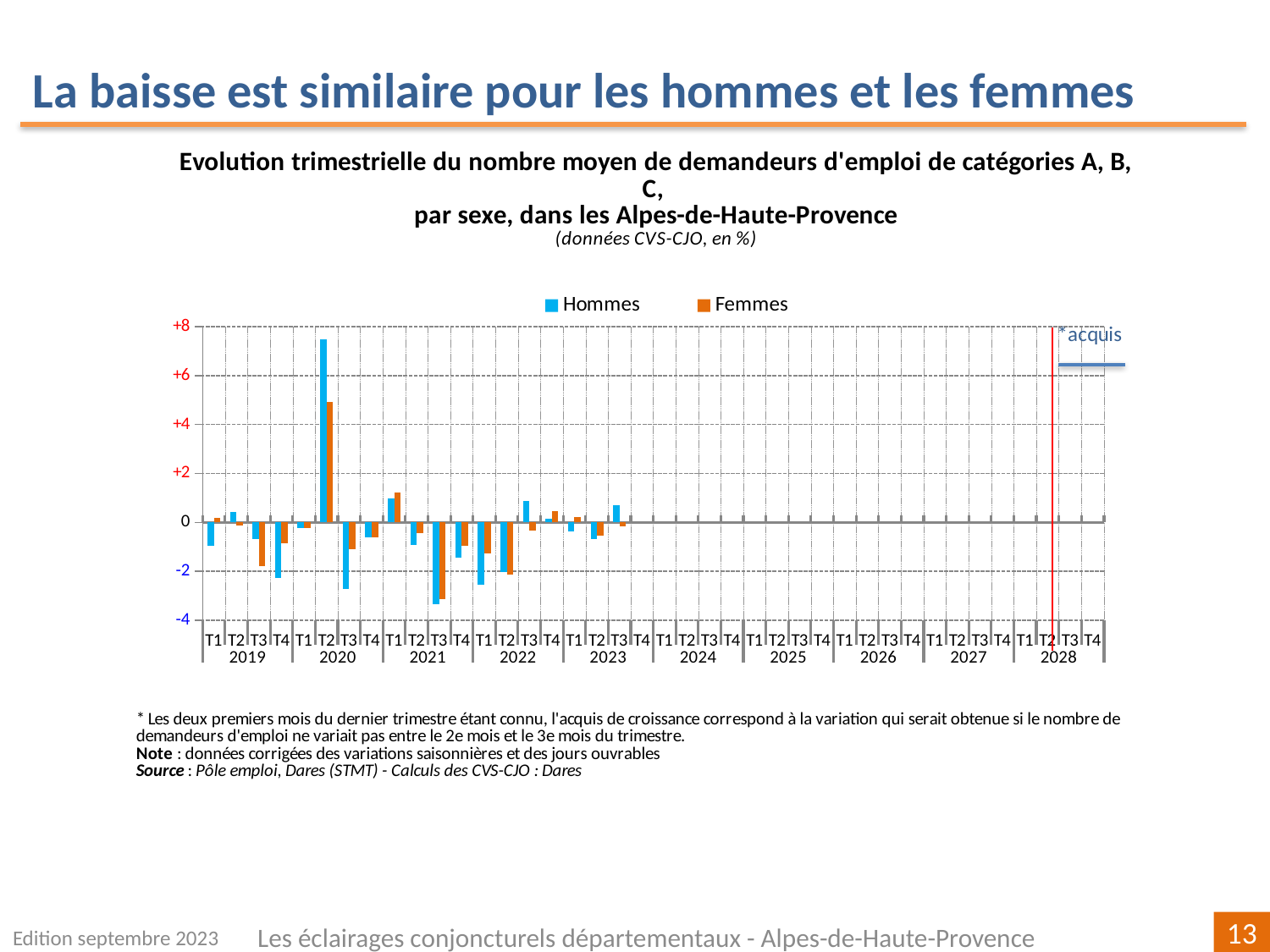
Is the value for Femmes in T2 2020 greater or less than +4? greater In T2 2020, which series has the larger value, Hommes or Femmes? Hommes Is the value for Hommes in T2 2020 greater or less than +6? greater How many years are labelled along the x axis? 10 Is the value for Hommes in T3 2021 greater or less than -2? less What is the unit indicated in the chart subtitle? % In which quarter does the Hommes series reach its highest value? T2 2020 What kind of chart is shown on the slide? bar chart How many series does the legend list? 2 In which quarter does the Femmes series reach its highest value? T2 2020 What are the two series named in the legend? Hommes and Femmes